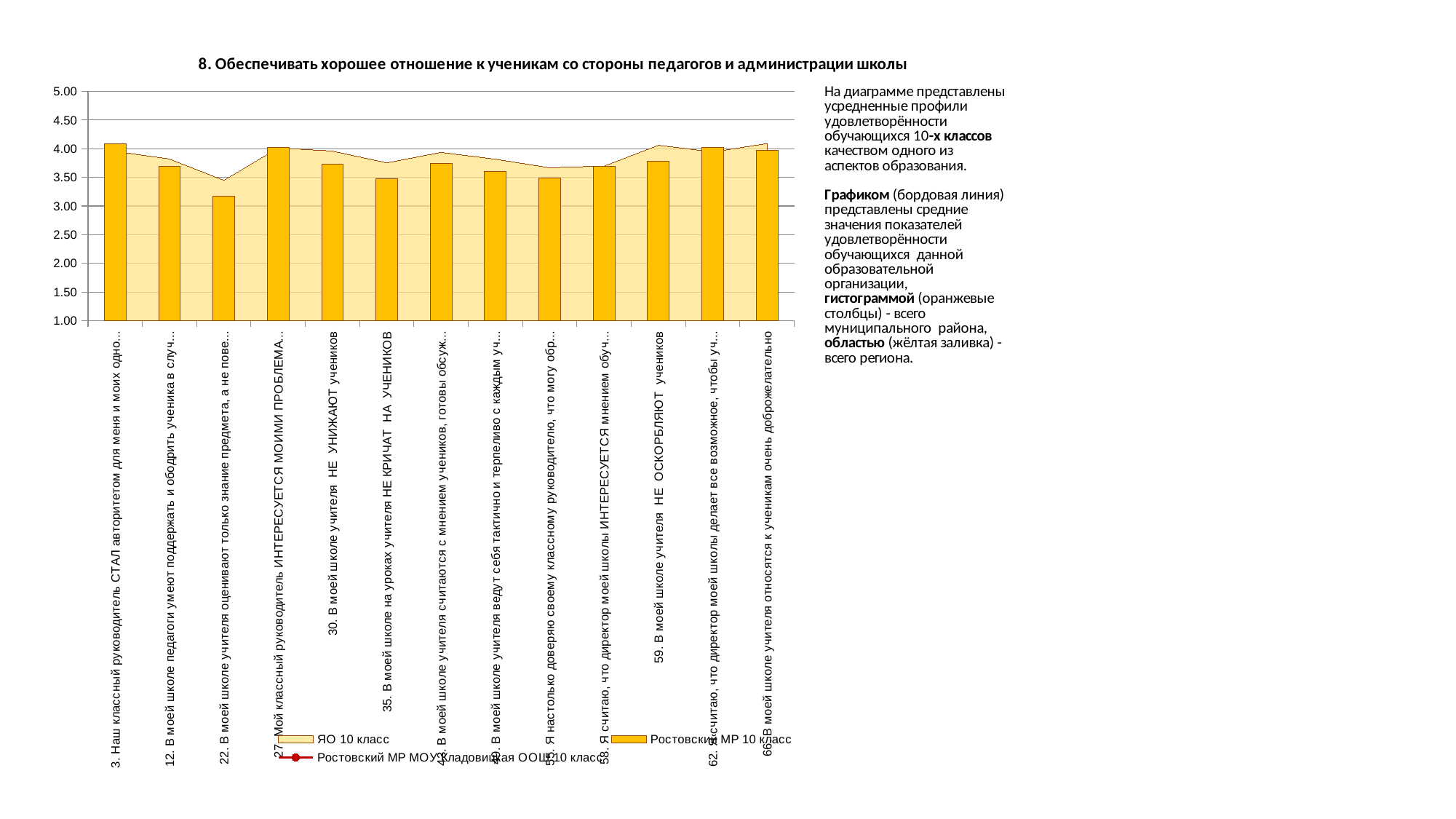
Which 'Ростовский МР 10 класс' bar is taller: '22. В моей школе учителя оценивают только знание предмета, а не пове…' or '30. В моей школе учителя НЕ УНИЖАЮТ учеников'? 30. В моей школе учителя НЕ УНИЖАЮТ учеников What is the lowest value shown on the chart's vertical axis? 1.00 Which 'Ростовский МР 10 класс' bar is taller: '3. Наш классный руководитель СТАЛ авторитетом для меня и моих одно…' or '22. В моей школе учителя оценивают только знание предмета, а не пове…'? 3. Наш классный руководитель СТАЛ авторитетом для меня и моих одно… What is the title of the chart? 8. Обеспечивать хорошее отношение к ученикам со стороны педагогов и администрации школы Is the 'Ростовский МР 10 класс' bar for '30. В моей школе учителя НЕ УНИЖАЮТ учеников' greater or less than 3.50? greater How many series does the chart legend list? 3 Is the 'Ростовский МР 10 класс' bar for '22. В моей школе учителя оценивают только знание предмета, а не пове…' greater or less than 3.50? less Is the 'Ростовский МР 10 класс' bar for '3. Наш классный руководитель СТАЛ авторитетом для меня и моих одно…' greater or less than 4.00? greater What kind of chart is used to show the series 'Ростовский МР 10 класс'? bar chart How many categories are plotted along the x axis of the chart? 13 Which category has the lowest bar for 'Ростовский МР 10 класс'? 22. В моей школе учителя оценивают только знание предмета, а не пове…